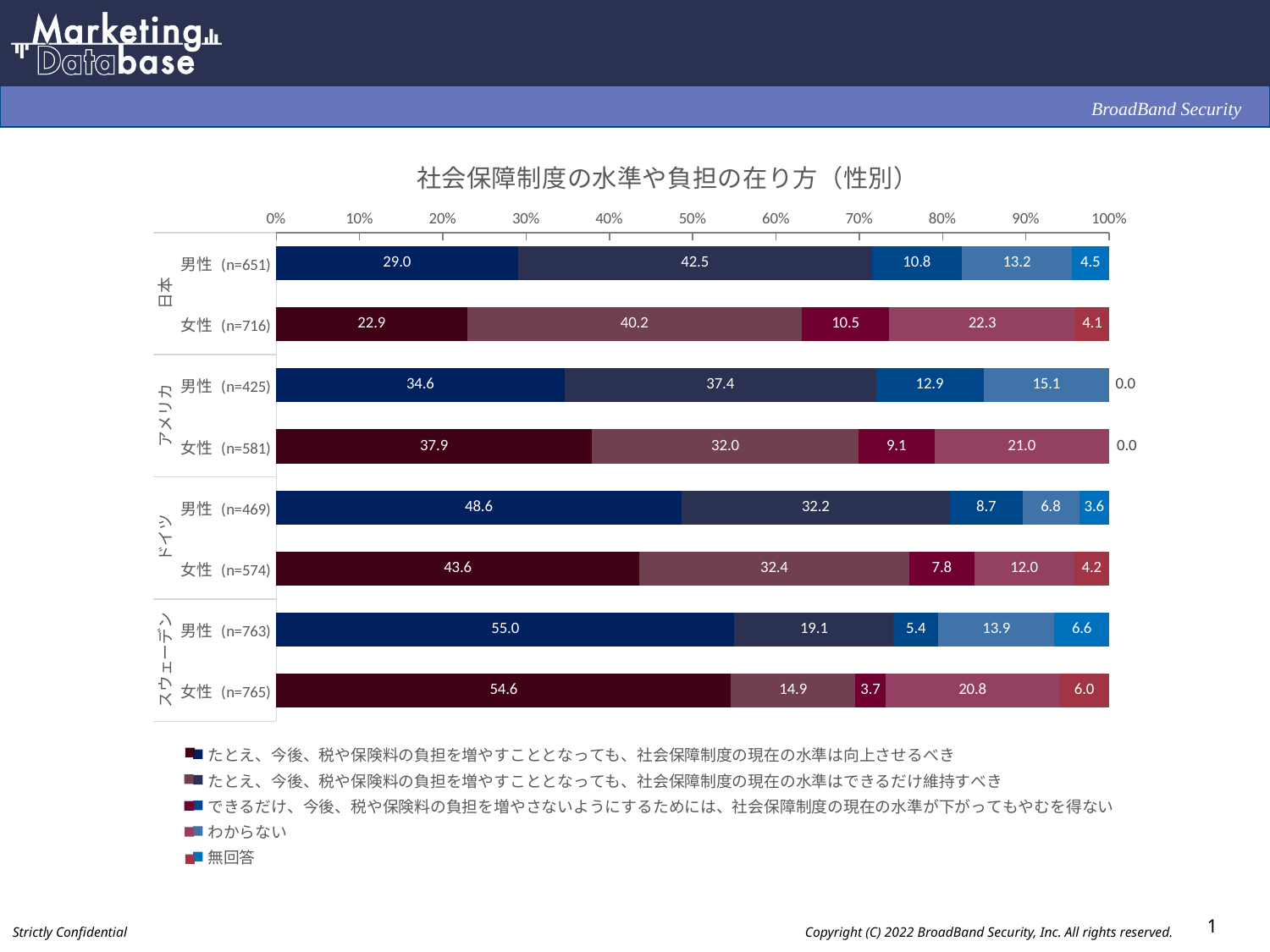
How many series does the legend list? 5 What is the difference between the second-segment values (現在の水準はできるだけ維持すべき) for 日本 男性 (n=651) and 日本 女性 (n=716)? 2.3 What is the value of the 無回答 segment for アメリカ 男性 (n=425)? 0.0 Which is larger: the わからない value for アメリカ 女性 (n=581) or for アメリカ 男性 (n=425)? アメリカ 女性 (n=581) Which bar has the highest value for the first segment (現在の水準は向上させるべき)? スウェーデン 男性 (n=763) What is the value of the second segment (現在の水準はできるだけ維持すべき) for ドイツ 女性 (n=574)? 32.4 How many bars (category rows) are plotted in the chart? 8 What is the value of the first segment (税や保険料の負担を増やすこととなっても、現在の水準は向上させるべき) for スウェーデン 男性 (n=763)? 55.0 What is the value of the わからない segment for 日本 女性 (n=716)? 22.3 What is the title of the chart? 社会保障制度の水準や負担の在り方（性別） Which bar has the lowest value for the first segment (現在の水準は向上させるべき)? 日本 女性 (n=716) What type of chart is shown on the slide? Stacked bar chart